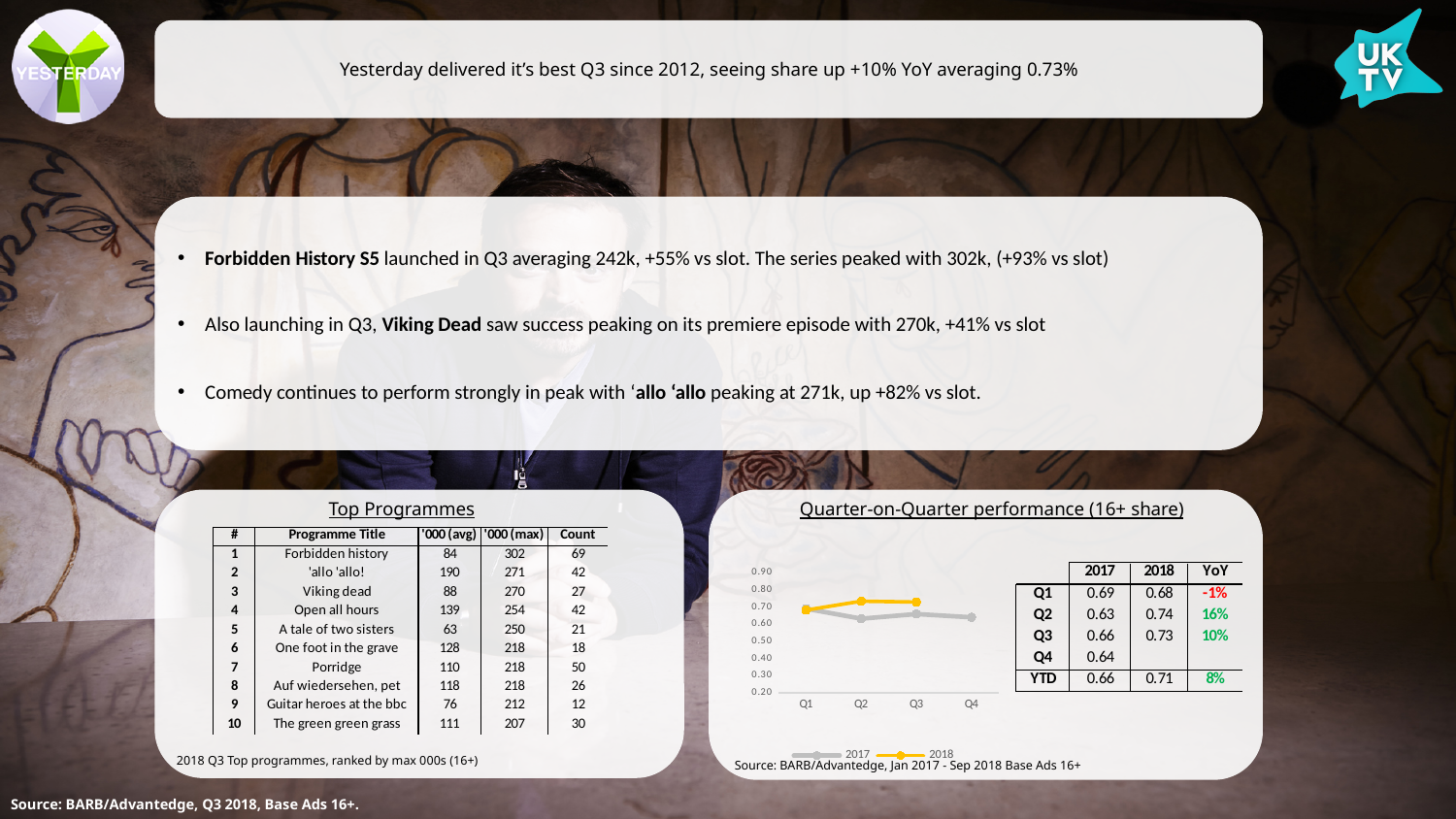
In the 'Quarter-on-Quarter performance (16+ share)' chart, what is the 2018 share for Q2? 0.74 In the 'Quarter-on-Quarter performance (16+ share)' chart, how many data points does the 2018 series have? 3 In the 'Quarter-on-Quarter performance (16+ share)' chart, is the 2018 value for Q3 greater or less than 0.70? greater In the 'Quarter-on-Quarter performance (16+ share)' chart, does the 2018 series rise or fall from Q1 to Q2? rise What type of chart is the 'Quarter-on-Quarter performance (16+ share)' chart? line chart In the 'Quarter-on-Quarter performance (16+ share)' chart, what is the difference between the 2018 and 2017 values for Q2? 0.11 In the 'Quarter-on-Quarter performance (16+ share)' chart, which series has the larger value in Q2, 2017 or 2018? 2018 How many quarters are shown on the x axis of the 'Quarter-on-Quarter performance (16+ share)' chart? 4 In the 'Quarter-on-Quarter performance (16+ share)' chart, what is the 2017 share for Q4? 0.64 In the 'Quarter-on-Quarter performance (16+ share)' chart, is the 2017 value for Q2 greater or less than 0.70? less How many series does the legend of the 'Quarter-on-Quarter performance (16+ share)' chart list? 2 In the 'Quarter-on-Quarter performance (16+ share)' chart, which quarter has the highest 2017 share? Q1